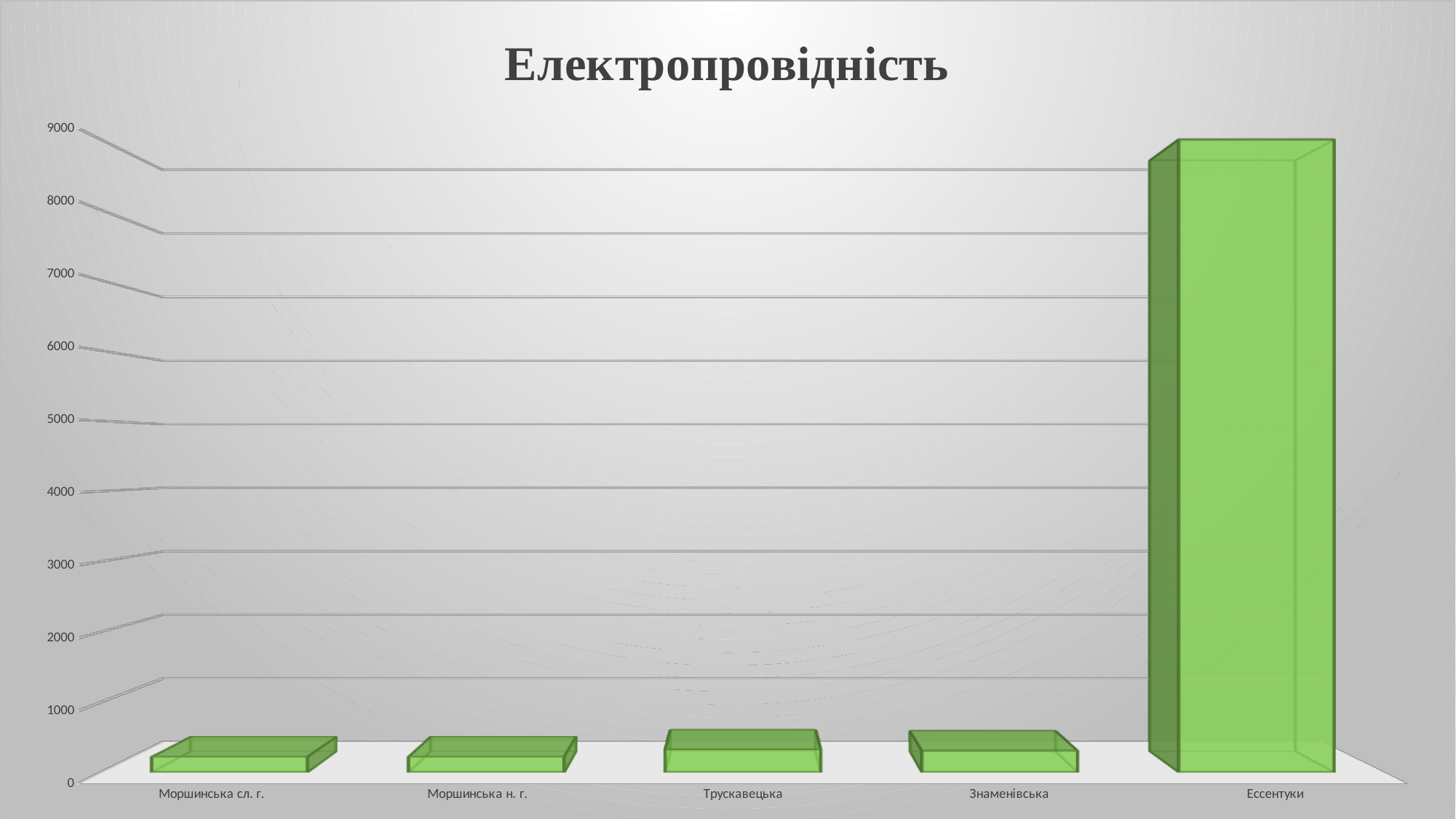
Is the value for Трускавецька greater or less than 1000? less Is the value for Знаменівська greater or less than 2000? less What is the title of the chart? Електропровідність What is the label of the last category on the x axis? Ессентуки Which has a larger value, Ессентуки or Трускавецька? Ессентуки What is the highest value shown on the vertical axis of the chart? 9000 What kind of chart is shown on the slide? bar chart How many categories are shown on the x axis of the chart? 5 Which has a larger value, Моршинська н. г. or Ессентуки? Ессентуки Is the value for Моршинська сл. г. greater or less than 1000? less Which category has the highest value in the chart? Ессентуки